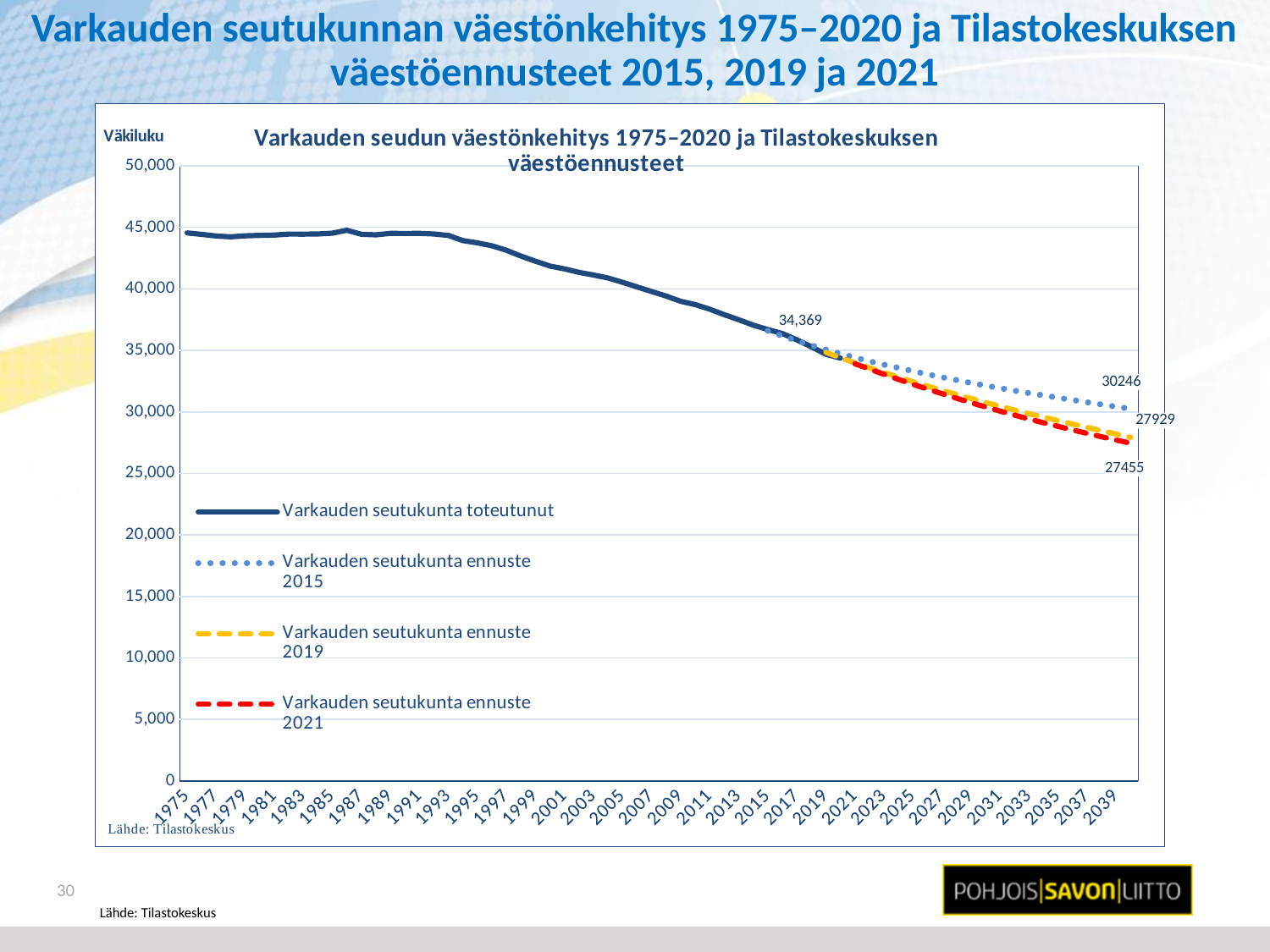
What is the final labelled value of the Varkauden seutukunta ennuste 2019 series? 27929 What value is printed as a data label on the Varkauden seutukunta toteutunut line? 34,369 Is the value of the Varkauden seutukunta toteutunut series in 1975 greater or less than 40,000? greater How many series does the chart legend list? 4 What is the final labelled value of the Varkauden seutukunta ennuste 2021 series? 27455 What kind of chart is shown on the slide? line chart Does the Varkauden seutukunta toteutunut series generally rise or fall from 1995 to 2020? fall What is the difference between the final labelled values of the 2019 forecast (27929) and the 2021 forecast (27455)? 474 Which forecast series ends at the lowest labelled value? Varkauden seutukunta ennuste 2021 Which forecast series ends at the highest labelled value? Varkauden seutukunta ennuste 2015 What is the final labelled value of the Varkauden seutukunta ennuste 2015 series? 30246 What is the difference between the final labelled values of the 2015 forecast (30246) and the 2021 forecast (27455)? 2791